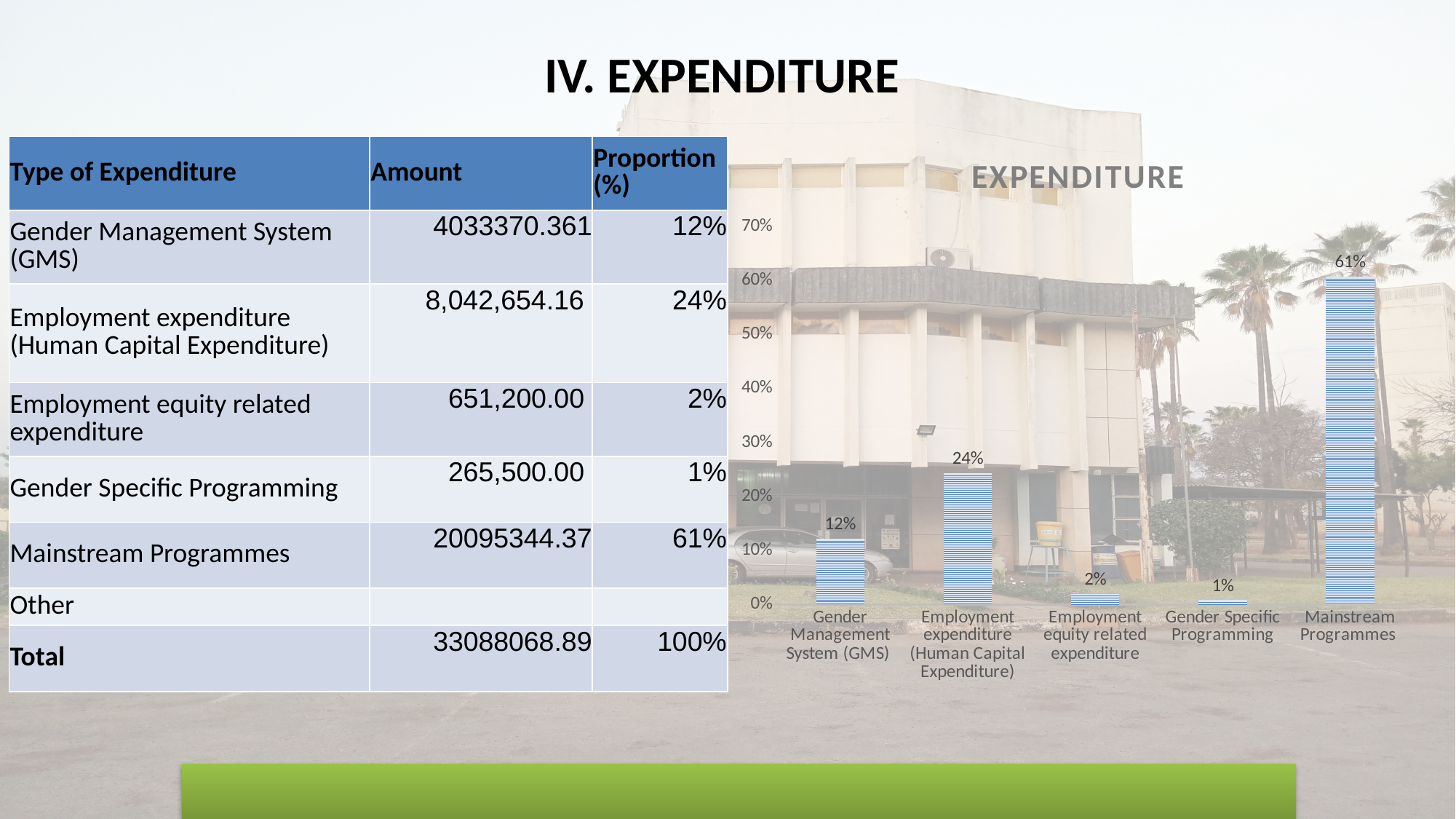
What is the value for Employment expenditure (Human Capital Expenditure) in the EXPENDITURE chart? 24% Which category has the lowest value in the EXPENDITURE chart? Gender Specific Programming Which is larger in the EXPENDITURE chart: Gender Management System (GMS) or Employment equity related expenditure? Gender Management System (GMS) How many categories are shown in the EXPENDITURE chart? 5 What is the value for Gender Management System (GMS) in the EXPENDITURE chart? 12% What kind of chart is the EXPENDITURE chart? bar chart What is the difference between the values for Mainstream Programmes and Employment expenditure (Human Capital Expenditure) in the EXPENDITURE chart? 37% What is the value for Gender Specific Programming in the EXPENDITURE chart? 1% What is the title of the chart on the slide? EXPENDITURE Which category has the highest value in the EXPENDITURE chart? Mainstream Programmes What is the value for Mainstream Programmes in the EXPENDITURE chart? 61% Is the value for Mainstream Programmes in the EXPENDITURE chart greater or less than 50%? greater